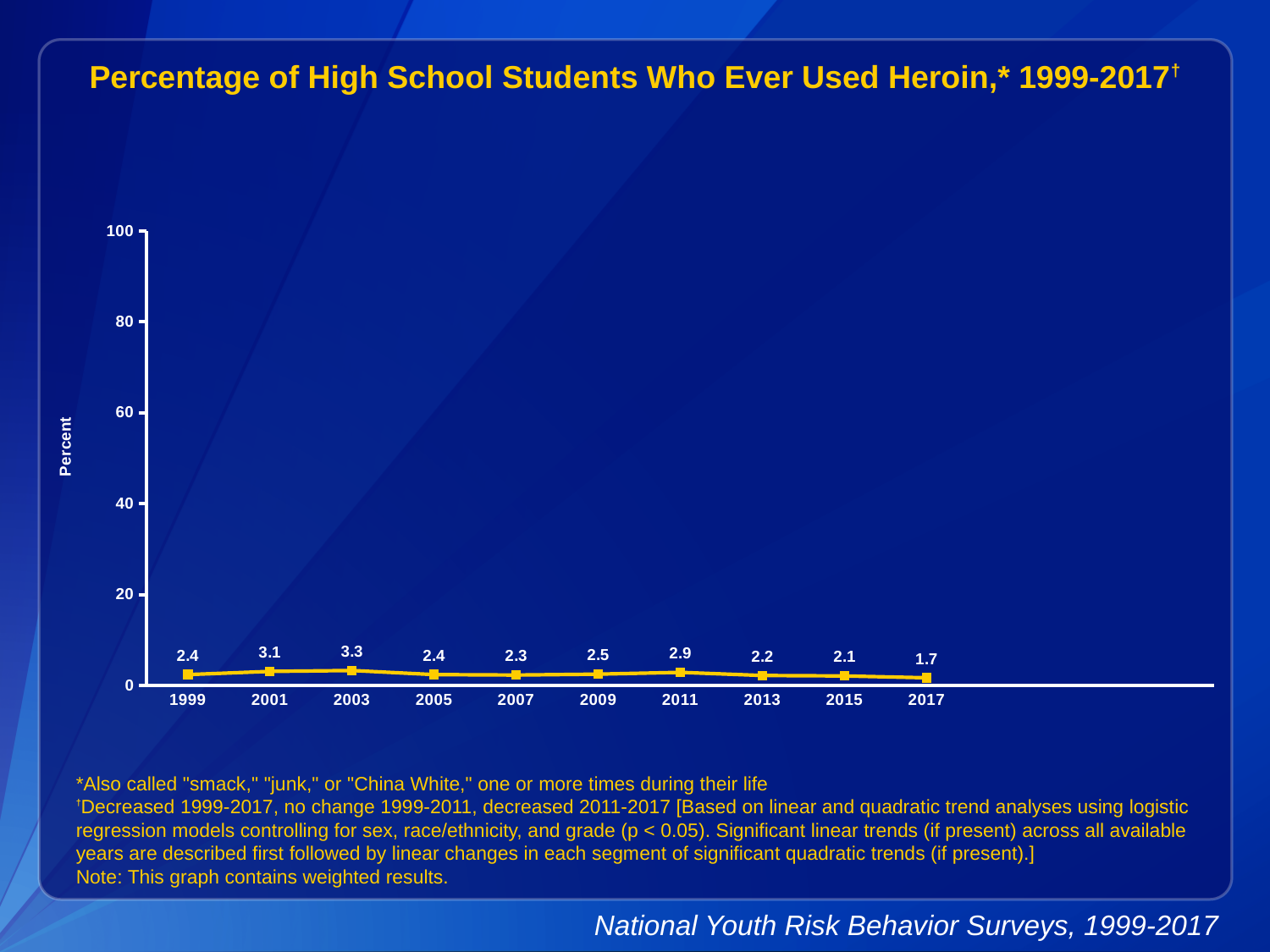
What is the value plotted for 2011? 2.9 Which year has the lowest percentage of students who ever used heroin? 2017 Did the percentage rise or fall from 2011 to 2017? fall What is the value plotted for 2017? 1.7 What percentage of high school students had ever used heroin in 2003? 3.3 Which year has the highest percentage of students who ever used heroin? 2003 How many years are plotted on the chart? 10 What is the label on the vertical axis? Percent Is the value for 2009 greater or less than 20? less Which year has a larger value, 2001 or 2013? 2001 What kind of chart is shown on the slide? line chart What is the difference between the values for 2003 and 2017? 1.6